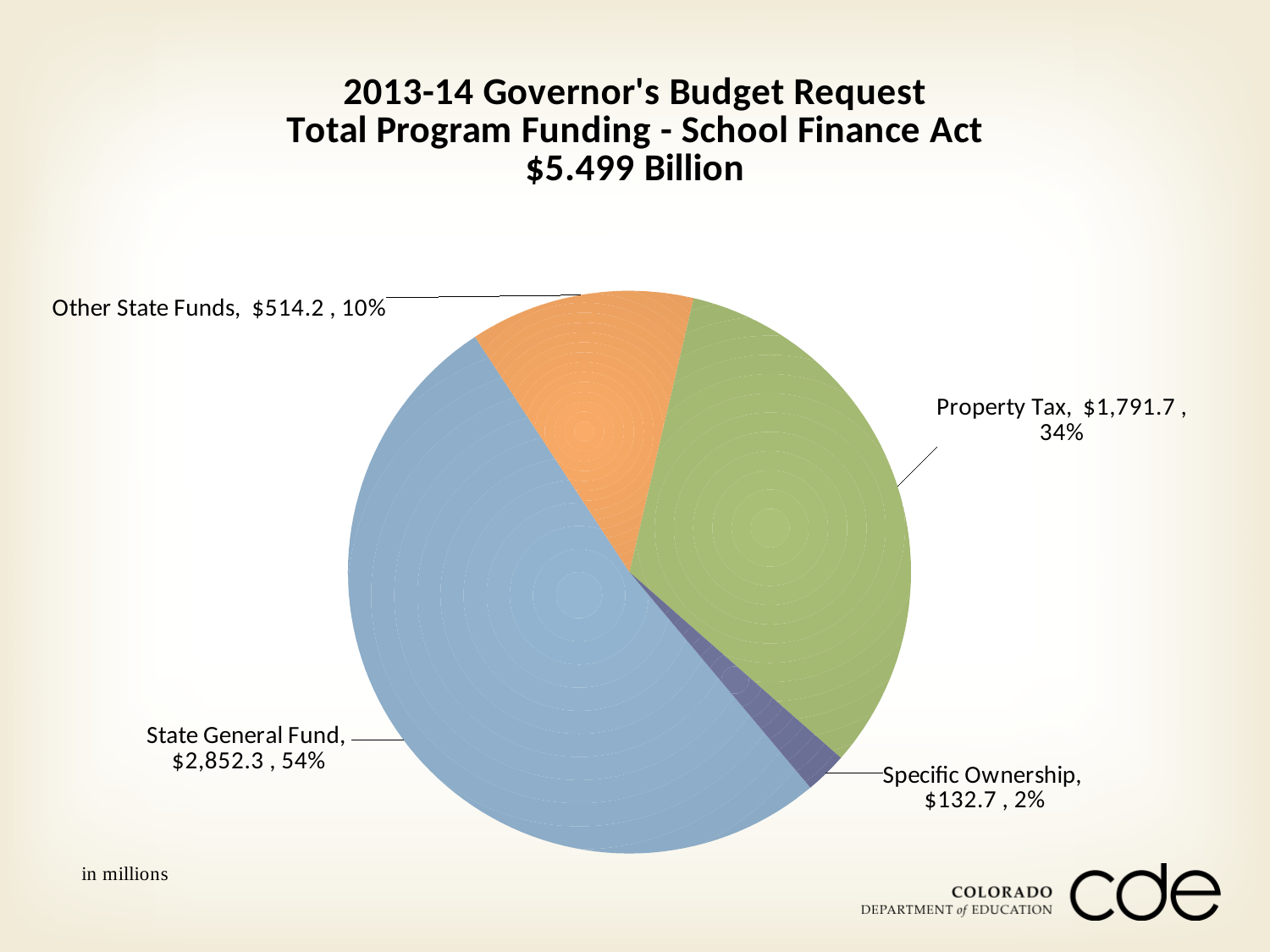
What type of chart is shown on the slide? pie chart Which is larger, Property Tax or Other State Funds? Property Tax What is the value for Specific Ownership? $132.7 What is the value for Property Tax? $1,791.7 Which category has the smallest slice? Specific Ownership What share of the pie does Other State Funds represent? 10% What share of the pie does Property Tax represent? 34% What is the value for State General Fund? $2,852.3 What total amount is stated in the chart title? $5.499 Billion How many slices does the pie chart have? 4 Which category has the largest slice? State General Fund What is the value for Other State Funds? $514.2